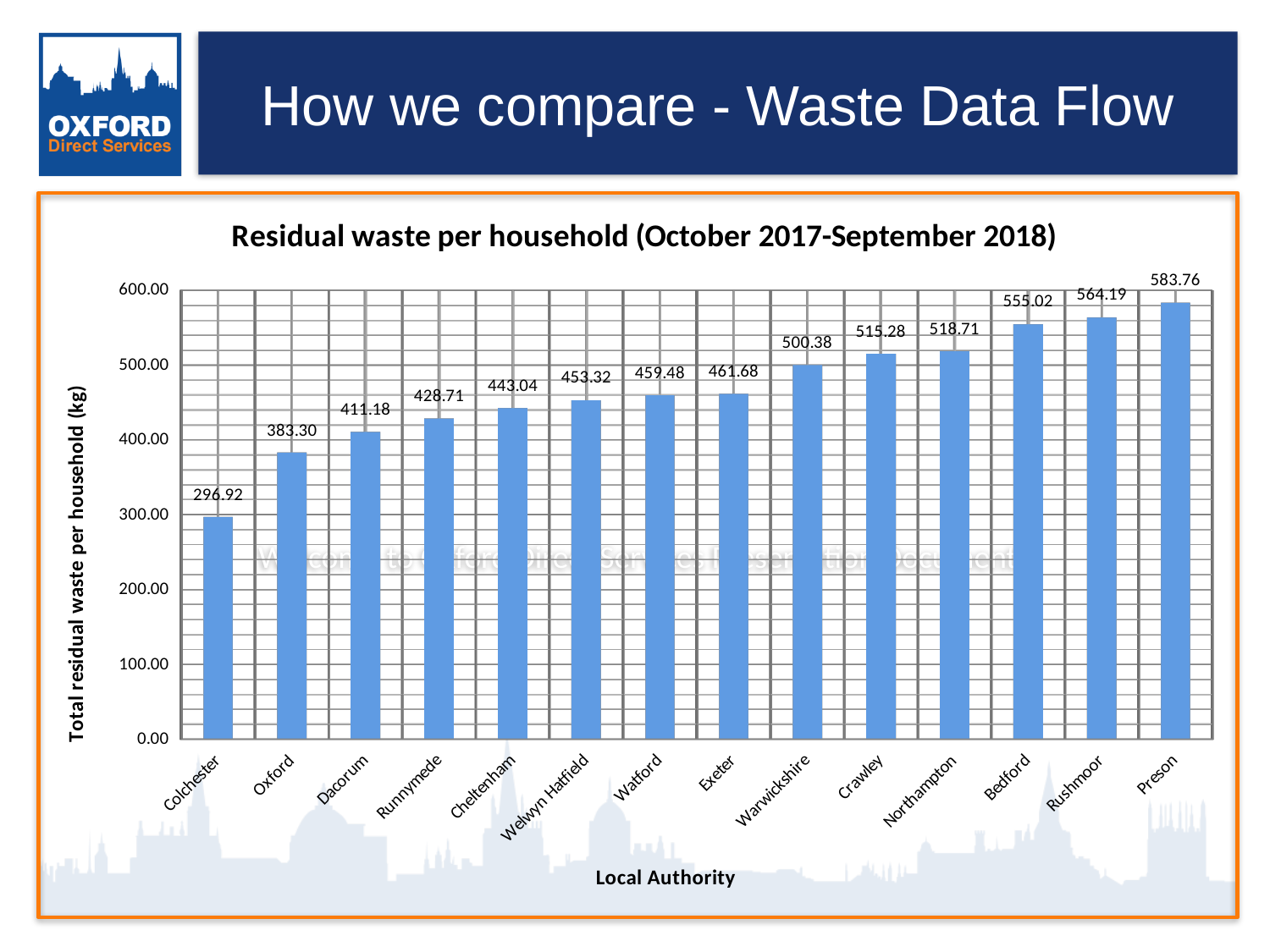
What is the difference between the values for Oxford and Colchester? 86.38 Which local authority has the highest residual waste per household? Preson Which local authority has the lowest residual waste per household? Colchester Which has a higher value, Crawley or Runnymede? Crawley What is the difference between the values for Bedford and Northampton? 36.31 How many local authorities are shown in the chart? 14 What is the title of the chart? Residual waste per household (October 2017-September 2018) What type of chart is used on this slide? Bar chart Is the value for Rushmoor greater or less than 500.00? greater What is the residual waste per household for Oxford? 383.30 What is the value shown for Warwickshire? 500.38 What is the value shown for Welwyn Hatfield? 453.32